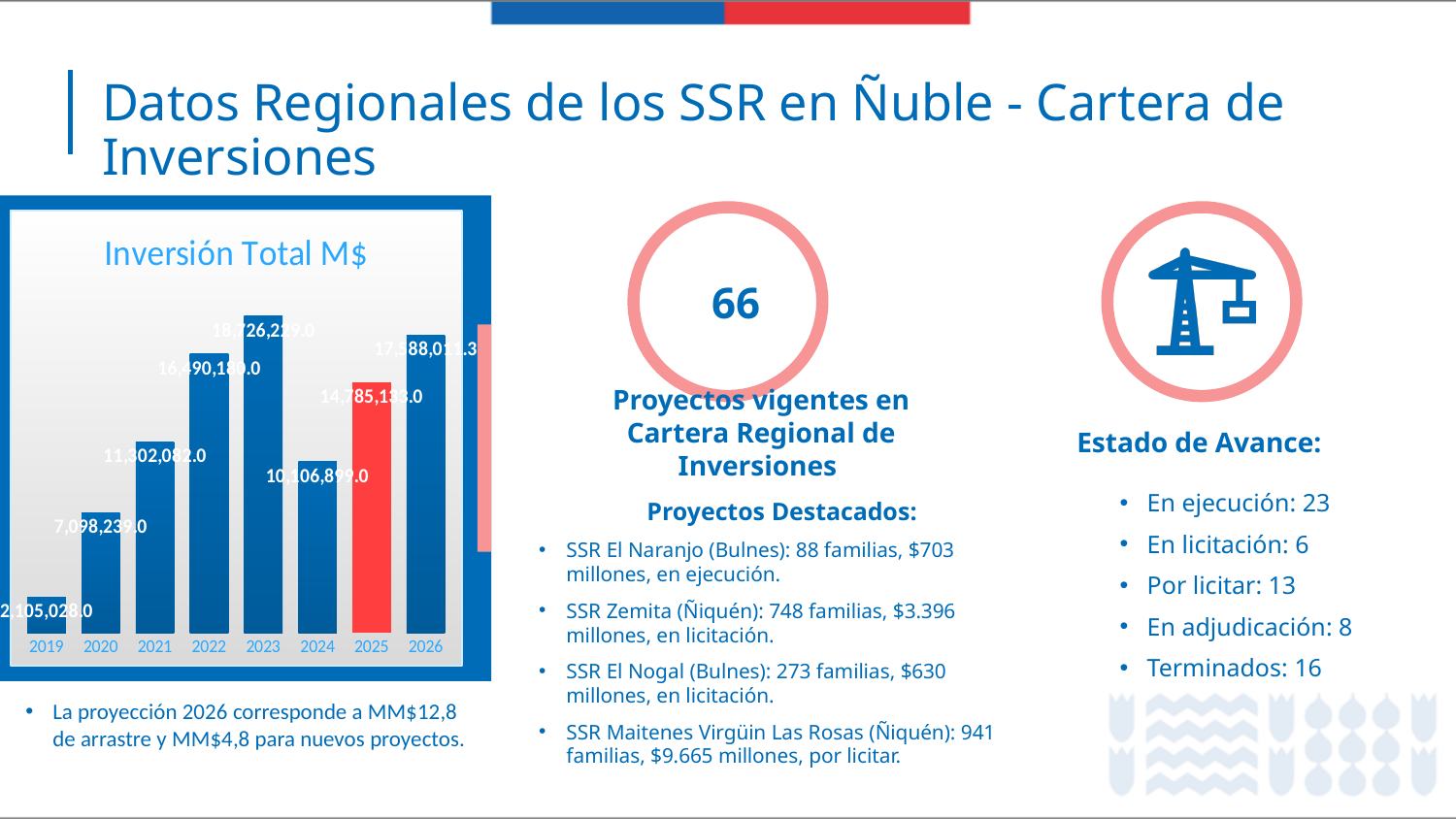
In the "Inversión Total M$" chart, which year's bar is coloured red instead of blue? 2025 In the "Inversión Total M$" chart, which is larger, the value for 2022 or the value for 2024? 2022 Which year has the highest value in the "Inversión Total M$" chart? 2023 Which year has the lowest value in the "Inversión Total M$" chart? 2019 In the "Inversión Total M$" chart, what is the value for 2024? 10,106,899.0 In the "Inversión Total M$" chart, what is the difference between the values for 2021 and 2020? 4,203,843.0 In the "Inversión Total M$" chart, do the values rise or fall from 2019 to 2023? rise What type of chart is shown under the title "Inversión Total M$"? bar chart What is the title of the chart on the left of the slide? Inversión Total M$ How many years are plotted in the "Inversión Total M$" chart? 8 In the "Inversión Total M$" chart, what is the value for 2020? 7,098,239.0 In the "Inversión Total M$" chart, what is the value for 2021? 11,302,082.0